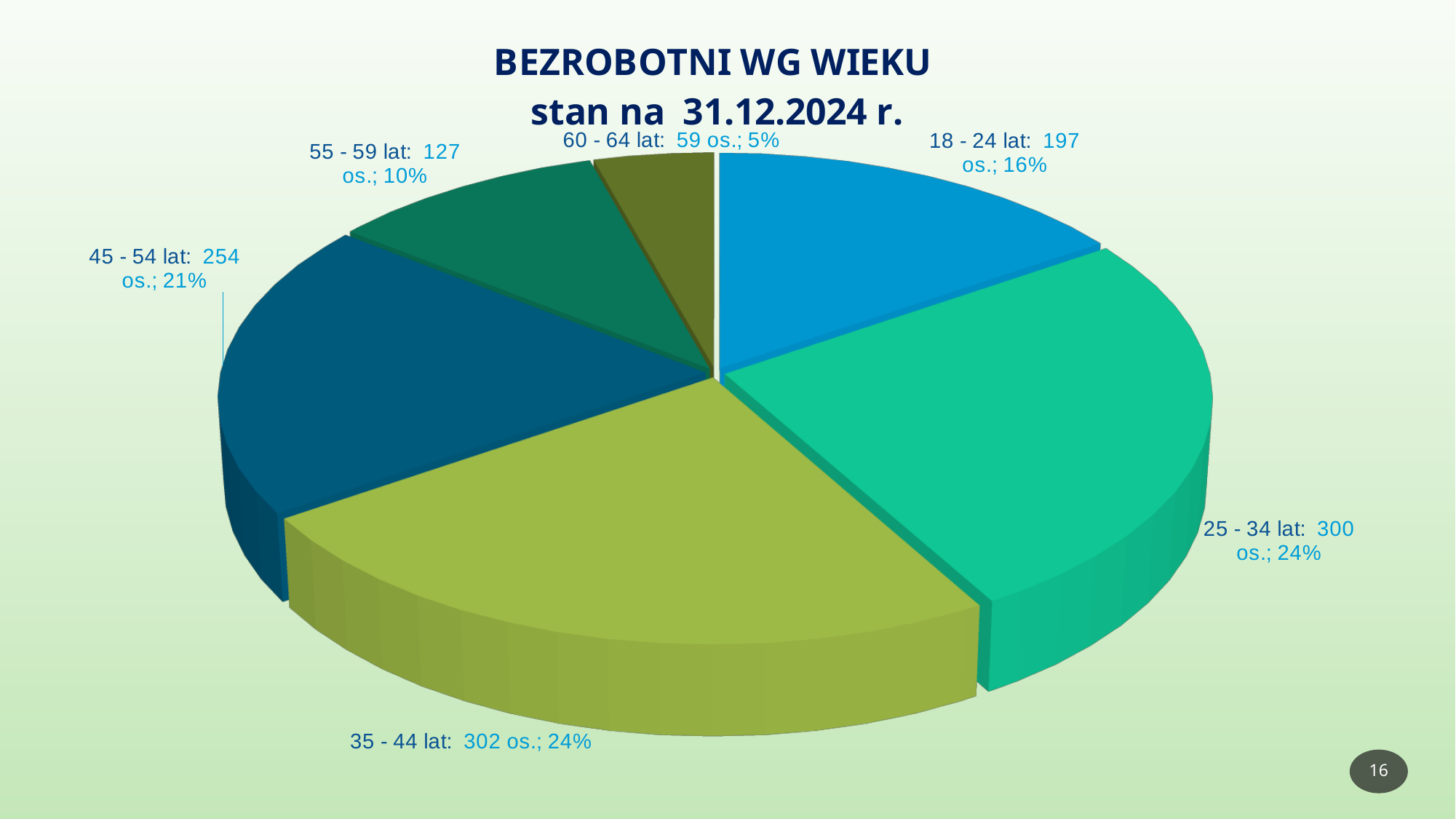
What percentage is shown for the 60 - 64 lat slice? 5% Which age group has the smallest number of unemployed people? 60 - 64 lat What kind of chart is shown on the slide? pie chart How many unemployed people are in the 18 - 24 lat group? 197 os. What is the difference in the number of people between the 35 - 44 lat group and the 60 - 64 lat group? 243 What is the value for the 55 - 59 lat group? 127 os. What date is given in the chart title? 31.12.2024 r. Which group has more unemployed people: 25 - 34 lat or 18 - 24 lat? 25 - 34 lat What is the difference in the number of people between the 45 - 54 lat group and the 55 - 59 lat group? 127 Which age group has the largest number of unemployed people? 35 - 44 lat How many age groups (slices) does the pie chart show? 6 What share of the pie does the 45 - 54 lat group represent? 21%